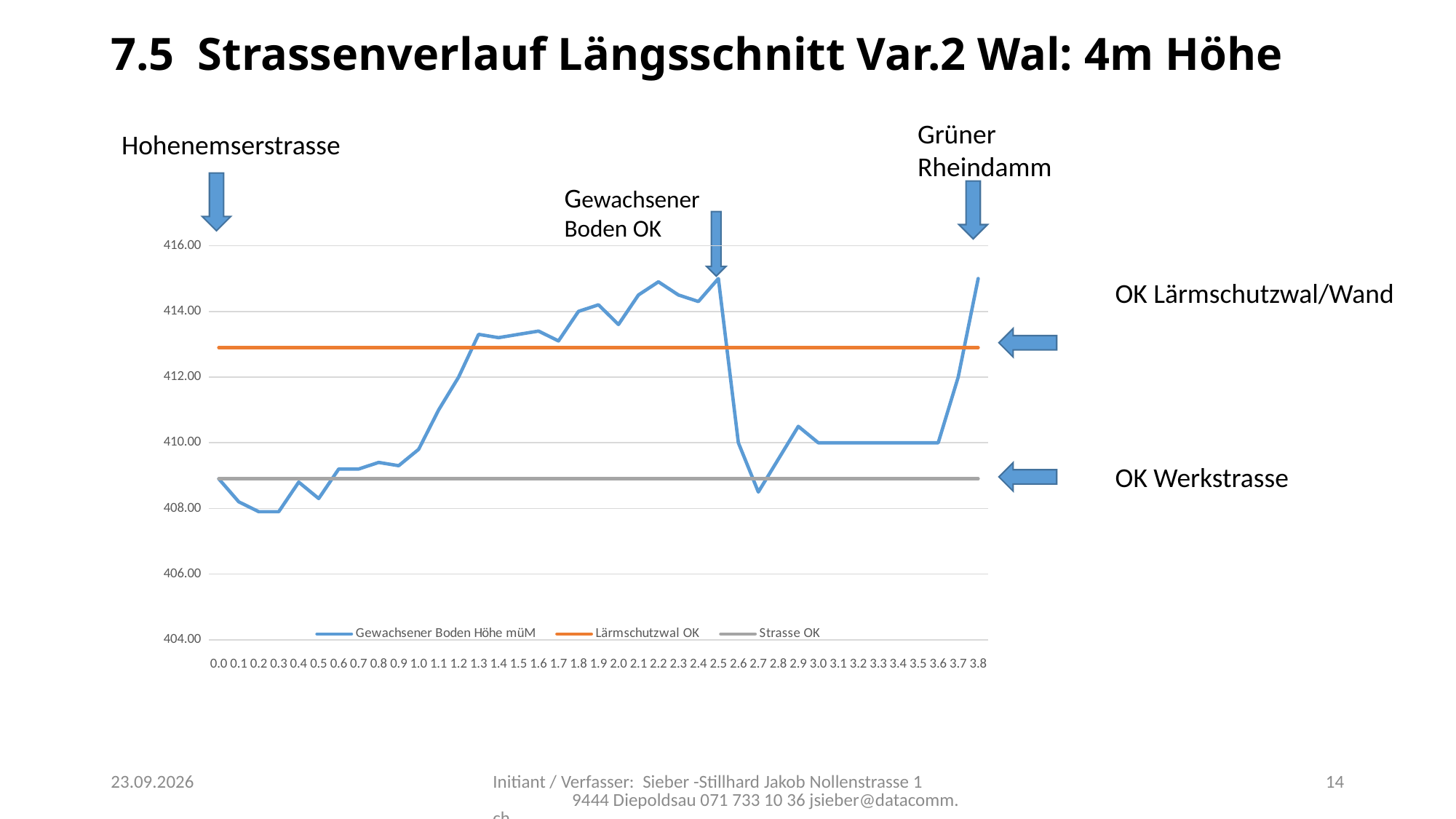
Does the Gewachsener Boden Höhe müM line rise or fall between 3.5 and 3.8? rise How many series does the chart legend list? 3 Does the Gewachsener Boden Höhe müM line rise or fall between 2.5 and 2.7? fall How many points are plotted along the x axis (from 0.0 to 3.8)? 39 Is the value of Gewachsener Boden Höhe müM at 1.3 greater or less than 412.00? greater Which is larger, the Gewachsener Boden Höhe müM value at 2.5 or at 2.6? 2.5 What colour is the Lärmschutzwal OK line in the chart? orange Is the value of Gewachsener Boden Höhe müM at 0.0 greater or less than 410.00? less Is the value of Gewachsener Boden Höhe müM at 2.2 greater or less than 414.00? greater Which line is higher on the chart, Lärmschutzwal OK or Strasse OK? Lärmschutzwal OK What kind of chart is shown on the slide? line chart